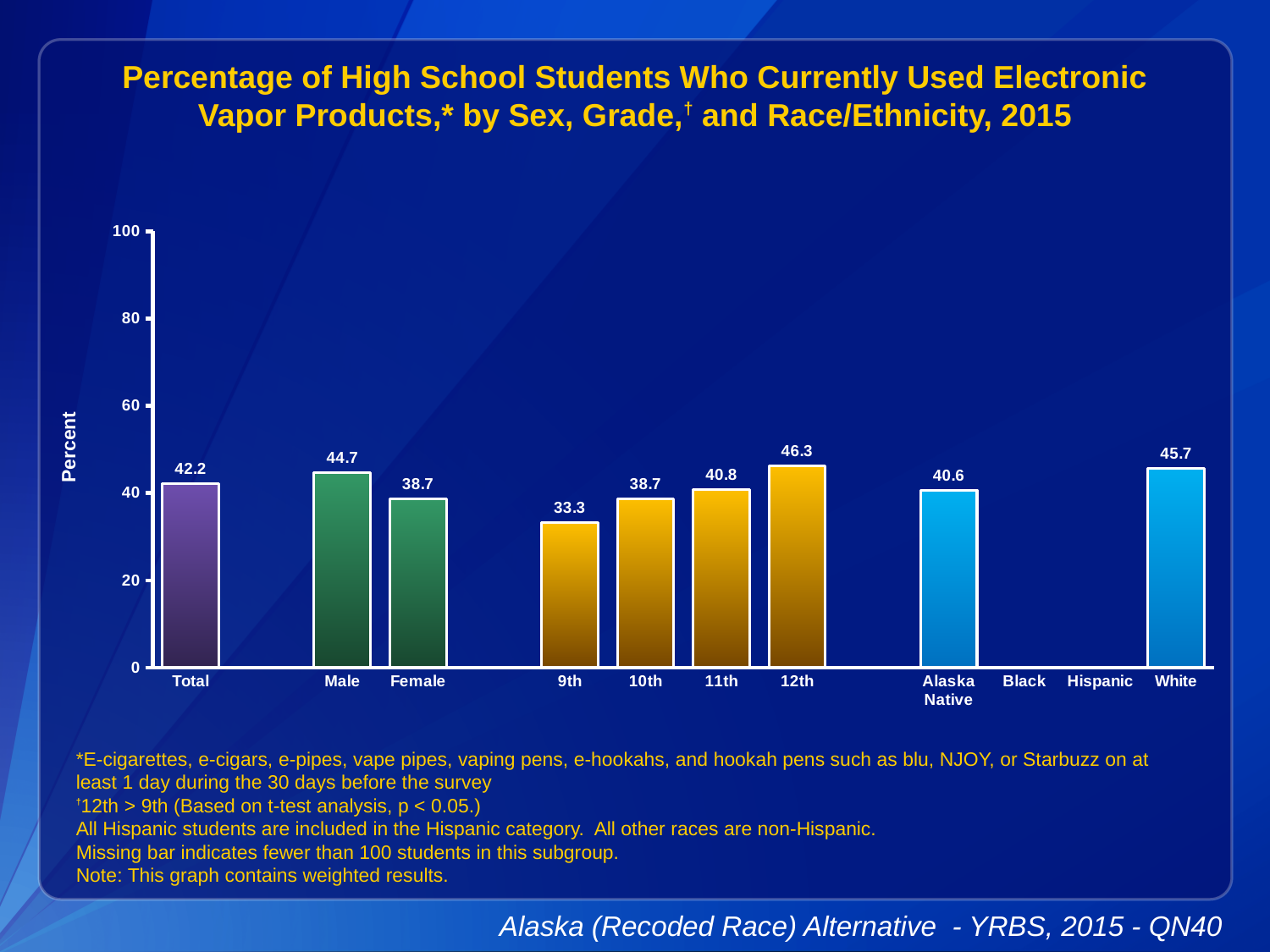
What is the value for Alaska Native? 40.6 Which category has the lowest value among the bars shown? 9th Do the values rise or fall from 9th grade to 12th grade? rise What is the difference between the 12th and 9th grade values? 13.0 What is the value for Male? 44.7 What is the value for Total? 42.2 What kind of chart is shown? bar chart Which is larger, the value for White or the value for Alaska Native? White Which grade has the highest value? 12th What is the value for 9th grade? 33.3 What is the difference between the Male and Female values? 6.0 Which race/ethnicity categories have no bar shown? Black and Hispanic